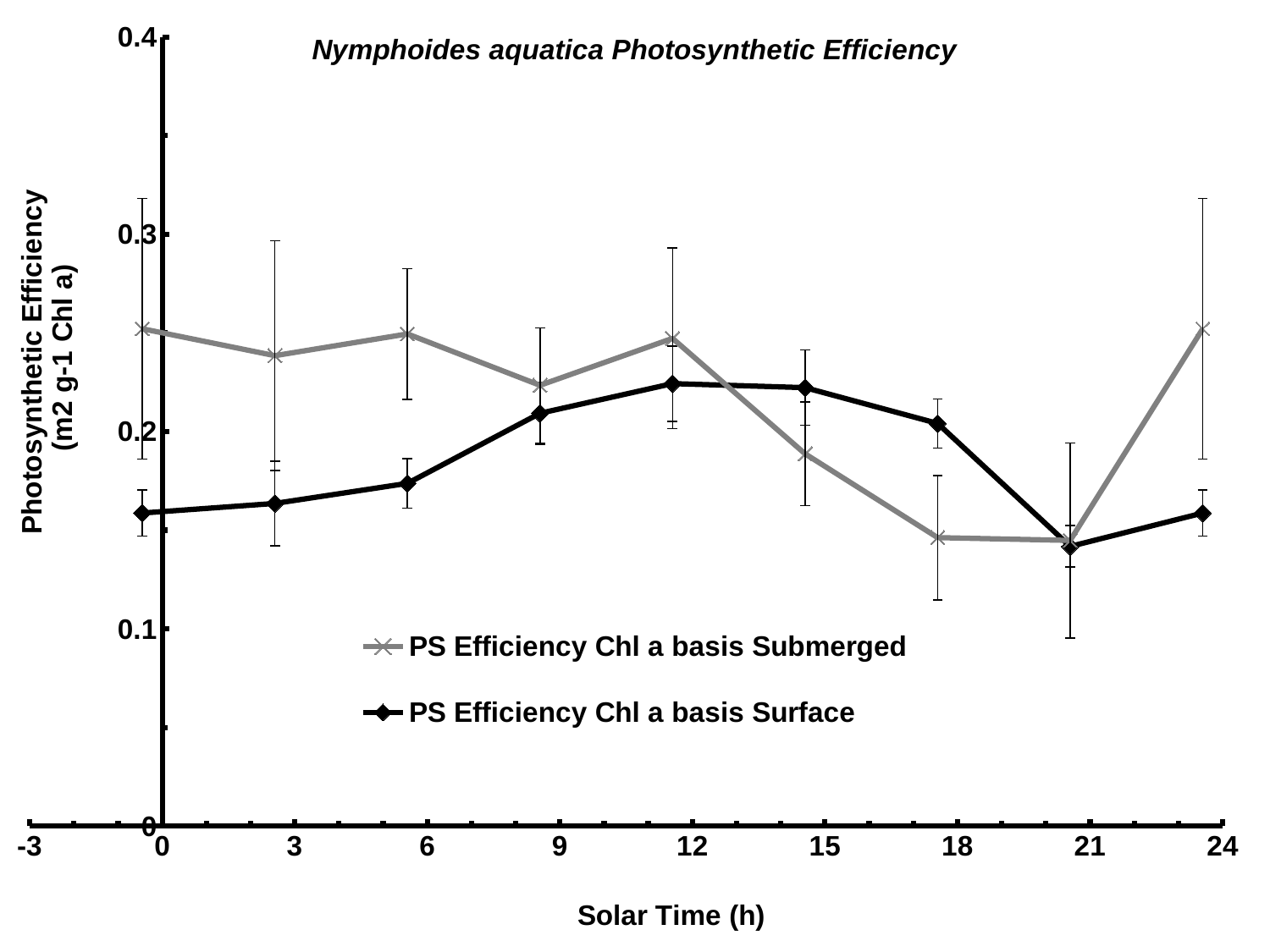
What is the title of the chart? Nymphoides aquatica Photosynthetic Efficiency Is the value for PS Efficiency Chl a basis Submerged at the first point (around 0 h) greater or less than 0.2? greater Is the value for PS Efficiency Chl a basis Surface at around 12 h greater or less than 0.2? greater What kind of chart is shown on the slide? line chart How many series does the legend list? 2 Is the value for PS Efficiency Chl a basis Surface at the first point (around 0 h) greater or less than 0.2? less What is the label of the x axis? Solar Time (h) Does the PS Efficiency Chl a basis Surface series rise or fall between 0 h and 12 h? rise At around 3 h, which series has the higher value, Submerged or Surface? PS Efficiency Chl a basis Submerged At around 15 h, which series has the higher value, Submerged or Surface? PS Efficiency Chl a basis Surface How many data points are plotted for the PS Efficiency Chl a basis Surface series? 9